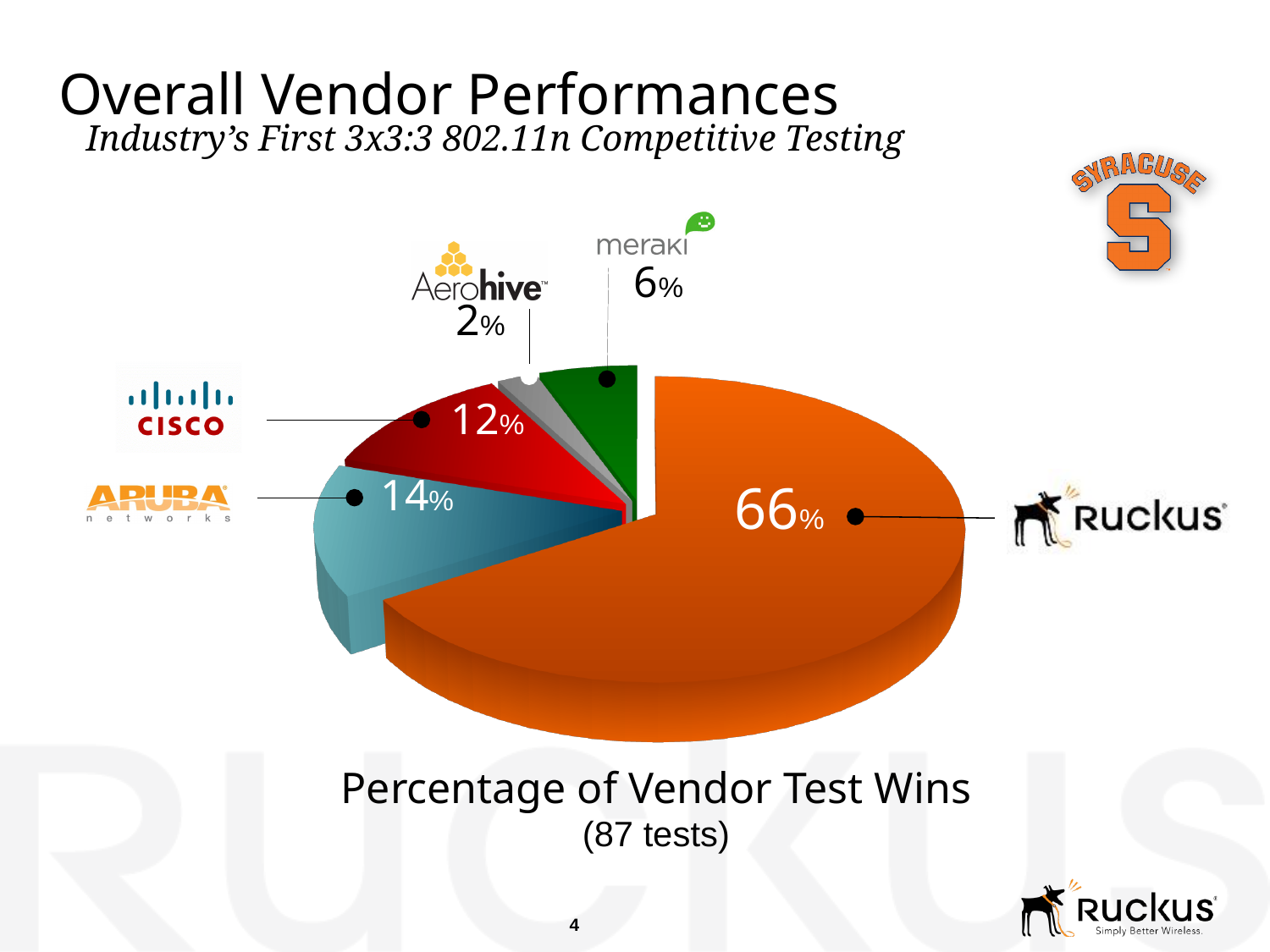
Which vendor has a larger share of test wins, Cisco or Meraki? Cisco What percentage of vendor test wins does Meraki have? 6% How many vendors are shown in the pie chart? 5 What percentage of vendor test wins does Ruckus have? 66% What is the difference in percentage points between Ruckus's and Aruba's shares of test wins? 52 What percentage of vendor test wins does Aruba have? 14% Which vendor has the smallest share of test wins? Aerohive What kind of chart is shown on the slide? Pie chart What percentage of vendor test wins does Cisco have? 12% How many tests does the chart caption say the percentages are based on? 87 tests What percentage of vendor test wins does Aerohive have? 2% Which vendor has the largest share of test wins? Ruckus